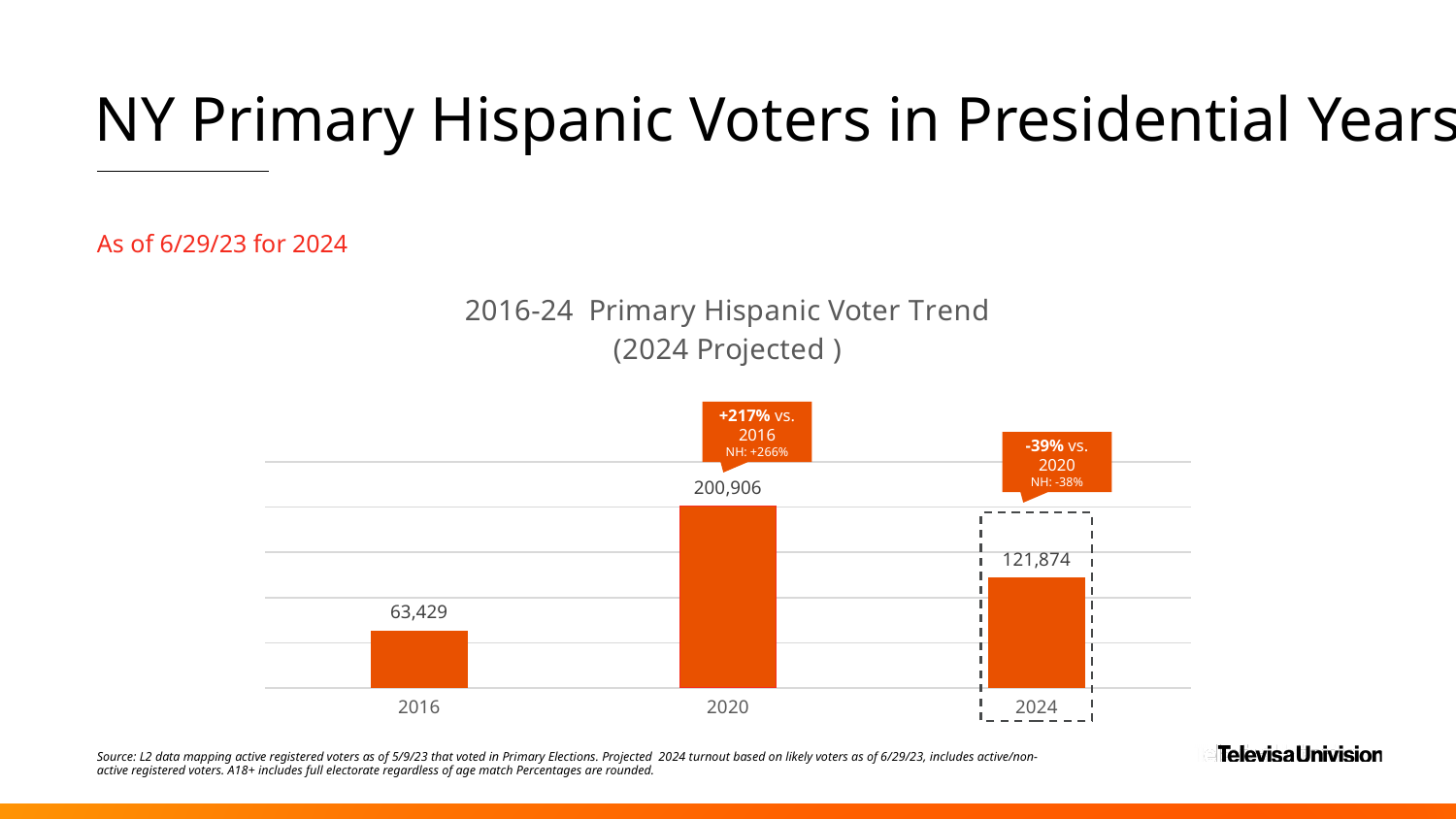
Do the values rise or fall from 2020 to 2024? Fall Which year has the highest value? 2020 Which year has the lowest value? 2016 How many years are shown on the x axis? 3 What is the projected value for 2024? 121,874 What percentage change vs. 2016 is shown in the callout above the 2020 bar? +217% What is the difference between the 2020 and 2024 values? 79,032 What kind of chart is shown? Bar chart Which is larger, the value for 2024 or the value for 2016? 2024 What is the value for 2020? 200,906 What is the value for 2016? 63,429 What is the difference between the 2020 and 2016 values? 137,477